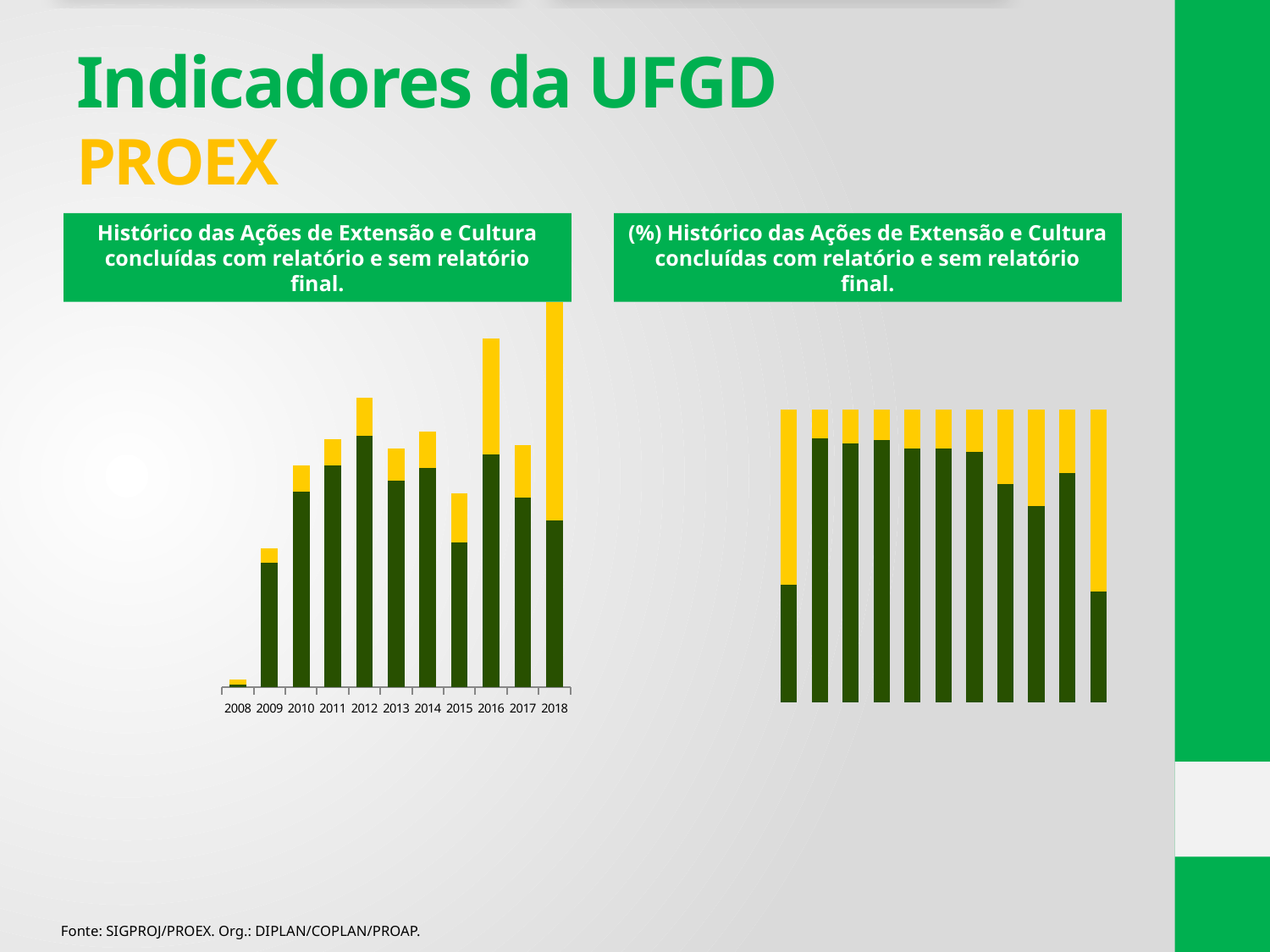
What two colours are used for the segments in the right chart? Dark green and yellow In the left chart, what is the first year shown on the x axis? 2008 What kind of chart is the left chart titled "Histórico das Ações de Extensão e Cultura concluídas com relatório e sem relatório final."? Stacked bar chart In the left chart, do the total bar heights rise from 2008 to 2009? Yes, they rise In the left chart, which year has the tallest yellow segment? 2018 In the left chart, which year has the shortest total bar? 2008 In the left chart, which year has the tallest total bar? 2018 In the left chart, which year has a taller total bar, 2016 or 2017? 2016 How many bars are shown in the right chart titled "(%) Histórico das Ações de Extensão e Cultura concluídas com relatório e sem relatório final."? 11 In the left chart, how many years are shown on the x axis? 11 In the left chart, which year has a taller dark green segment, 2012 or 2015? 2012 In the left chart, which year has the tallest dark green segment? 2012